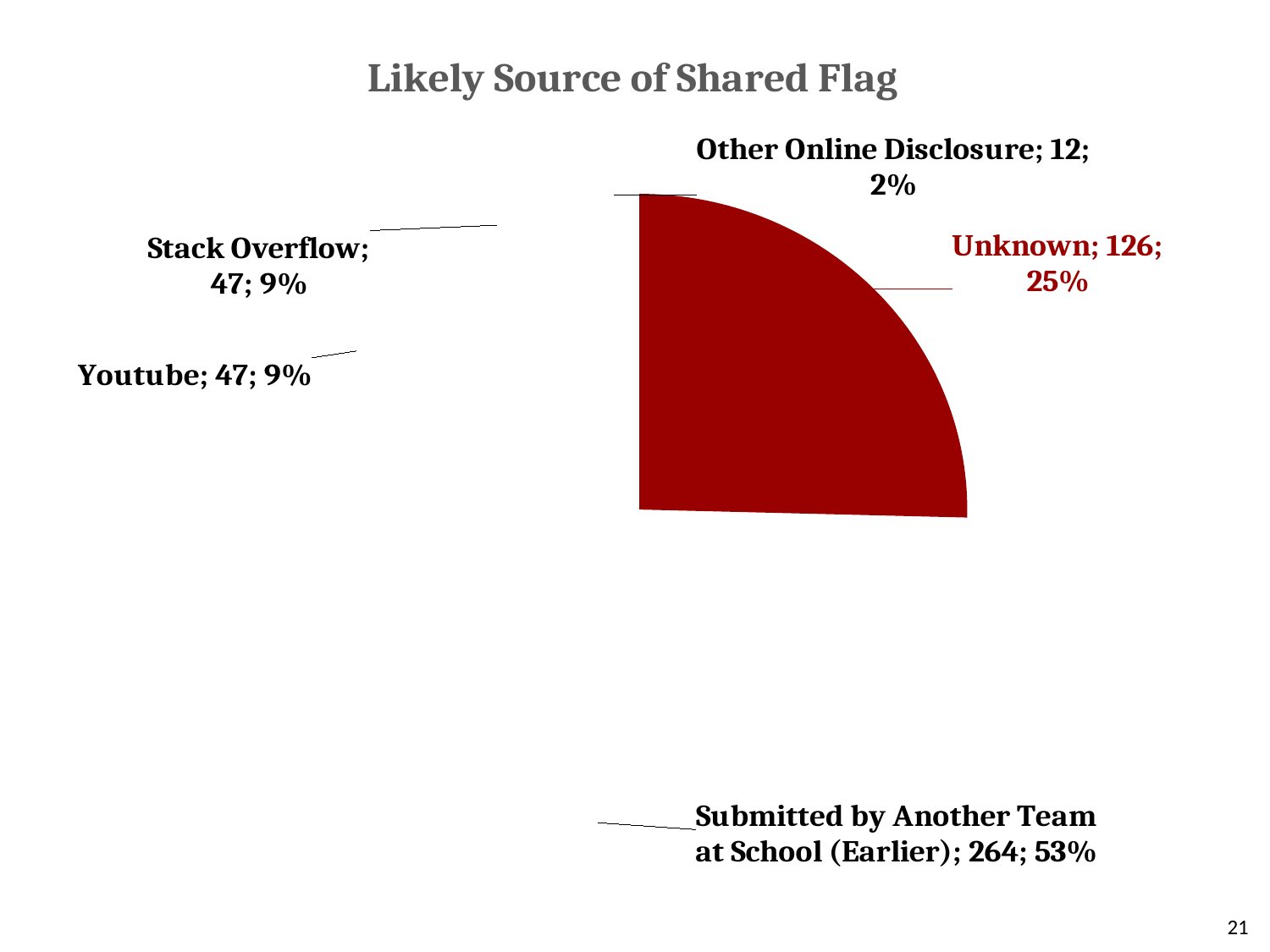
What is the value for Other Online Disclosure? 12 What is the difference between the values for Unknown and Stack Overflow? 79 Which category has the largest value? Submitted by Another Team at School (Earlier) Which is larger, the value for Unknown or the value for Youtube? Unknown What is the value for Unknown? 126 What percentage share does Stack Overflow have? 9% What percentage share does Submitted by Another Team at School (Earlier) have? 53% What is the title of the chart? Likely Source of Shared Flag What percentage share does Unknown have? 25% How many categories are labelled on the pie chart? 5 Which category has the smallest value? Other Online Disclosure What type of chart is shown on the slide? pie chart